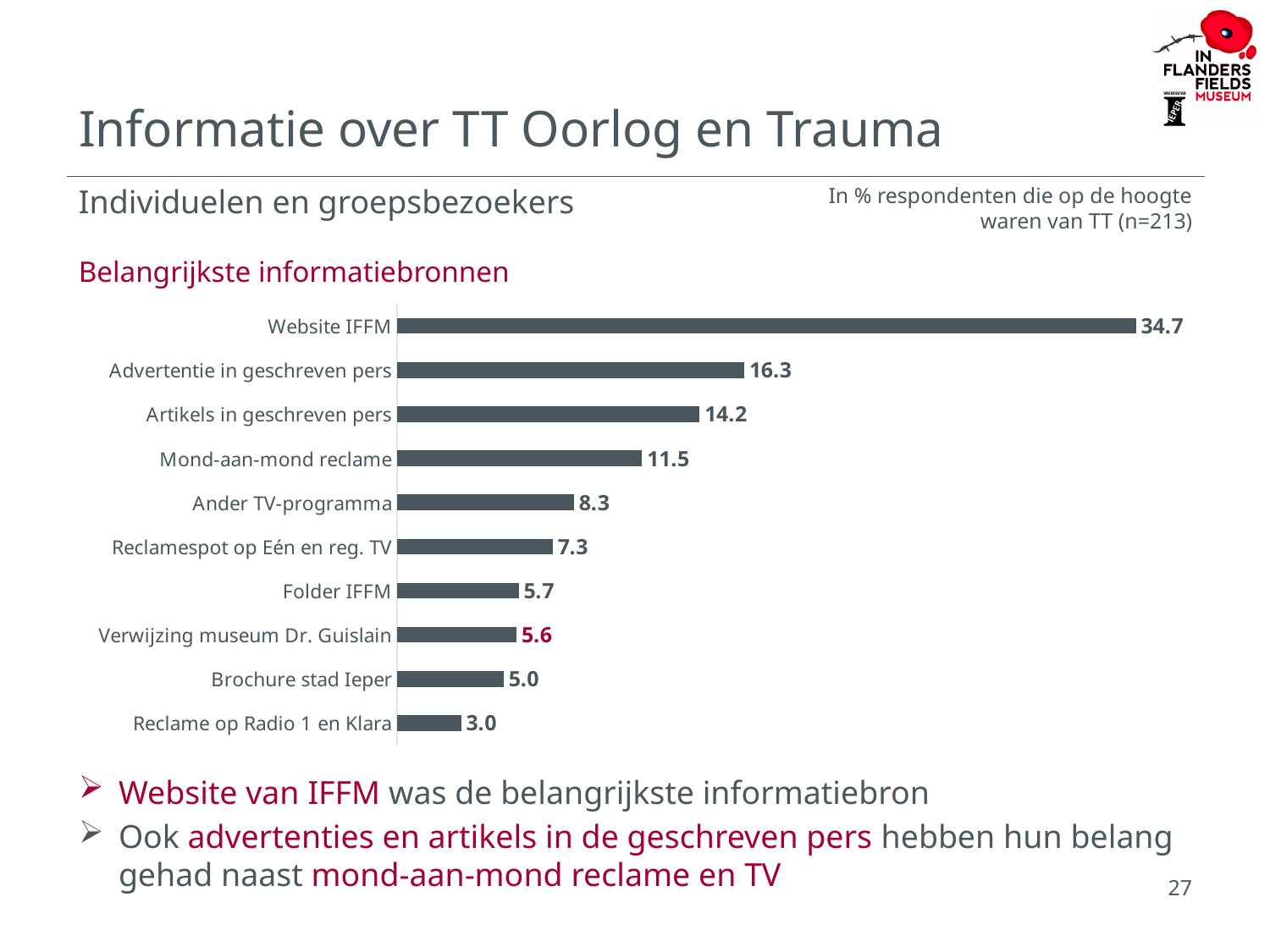
What is the title shown above the chart? Belangrijkste informatiebronnen What is the value for Folder IFFM? 5.7 What is the value for Website IFFM? 34.7 What is the difference between the values for Website IFFM and Reclame op Radio 1 en Klara? 31.7 What is the value for Verwijzing museum Dr. Guislain? 5.6 How many categories are shown in the chart? 10 What kind of chart is shown on the slide? bar chart Which category has the highest value? Website IFFM Which is larger, the value for Ander TV-programma or the value for Reclamespot op Eén en reg. TV? Ander TV-programma Which category has the lowest value? Reclame op Radio 1 en Klara What is the difference between the values for Advertentie in geschreven pers and Artikels in geschreven pers? 2.1 What is the value for Mond-aan-mond reclame? 11.5